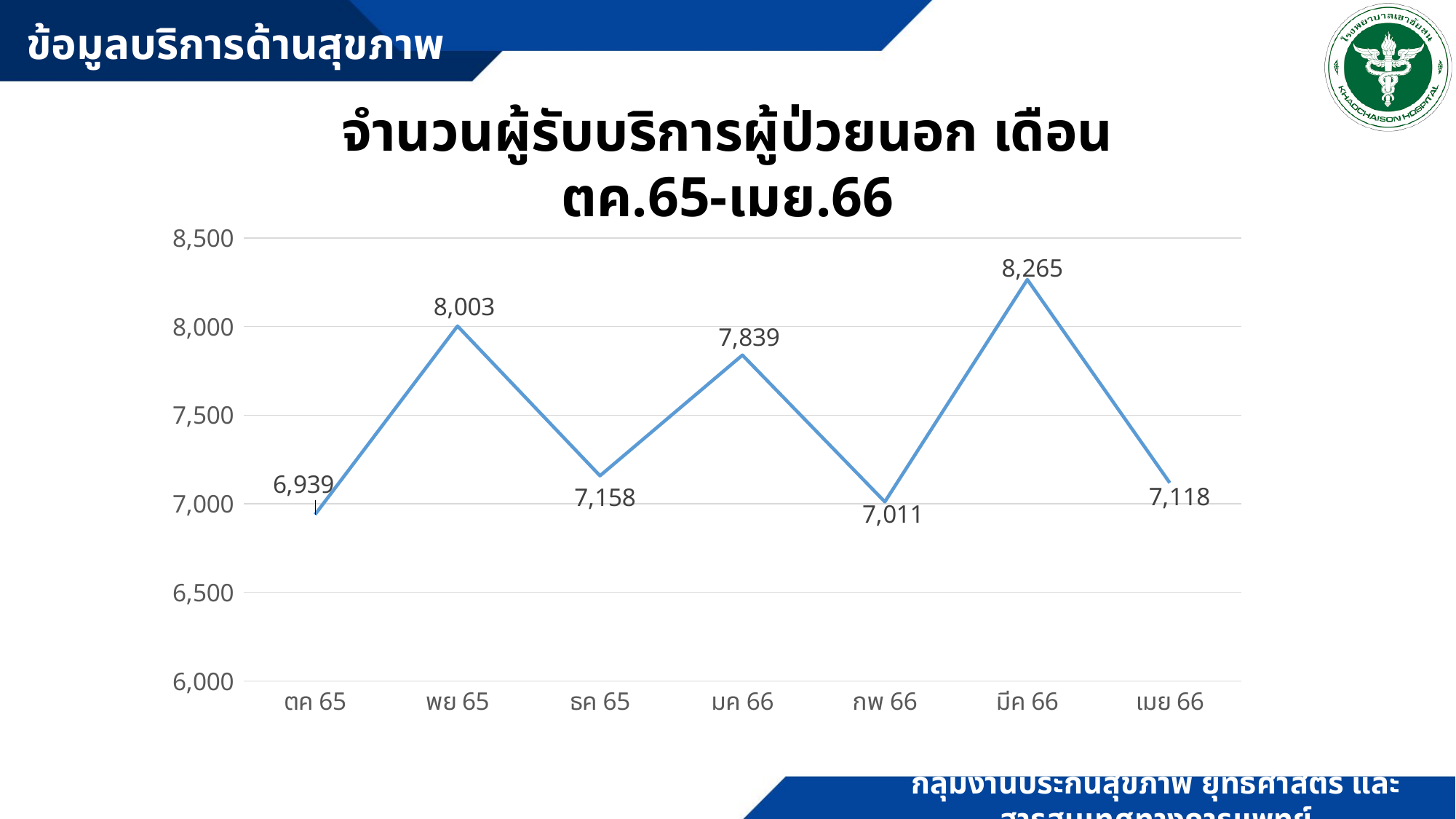
Is the value for กพ 66 greater or less than 7,500? less What is the value for เมย 66? 7,118 What is the value for มค 66? 7,839 How many months are plotted on the chart? 7 What is the difference between the values for มีค 66 and กพ 66? 1,254 What is the value for ตค 65? 6,939 Which month has the highest value? มีค 66 What type of chart is shown on the slide? line chart What is the difference between the values for พย 65 and ธค 65? 845 Which month has the lowest value? ตค 65 What is the title of the chart? จำนวนผู้รับบริการผู้ป่วยนอก เดือน ตค.65-เมย.66 Which is larger, the value for ธค 65 or the value for เมย 66? ธค 65